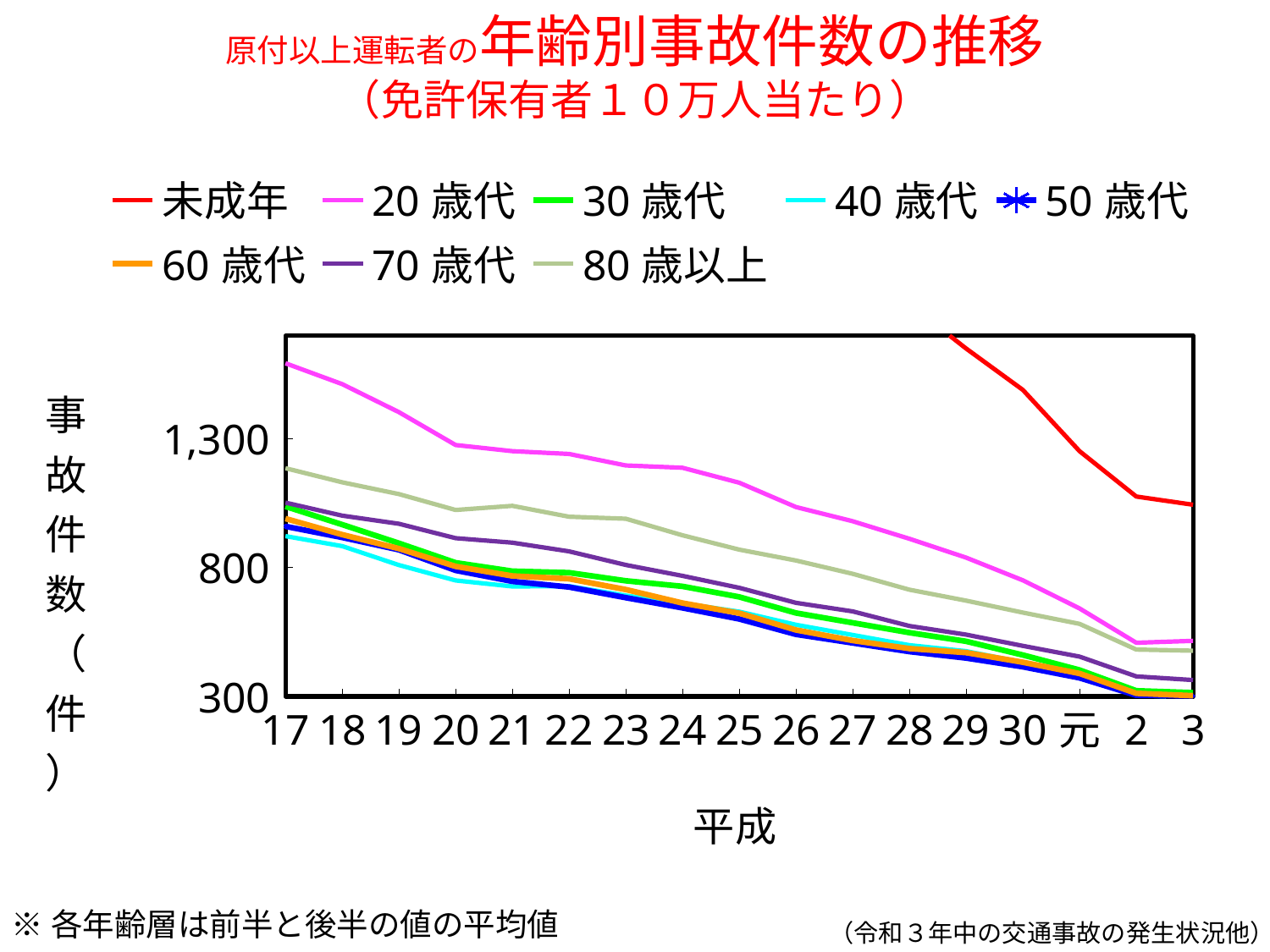
Is the value for 20歳代 at 17 greater or less than 1,300? greater Is the value for 未成年 at 3 greater or less than 800? greater How many series does the legend list? 8 What kind of chart is shown on the slide? line chart Is the value for 70歳代 at 17 greater or less than 800? greater What colour is the line for 未成年 in the legend? red At 3, which is larger, the value for 未成年 or the value for 20歳代? 未成年 Do the values for 20歳代 rise or fall from 17 to 3 along the x axis? fall How many year points are shown along the x axis? 17 At 17, which is larger, the value for 20歳代 or the value for 80歳以上? 20歳代